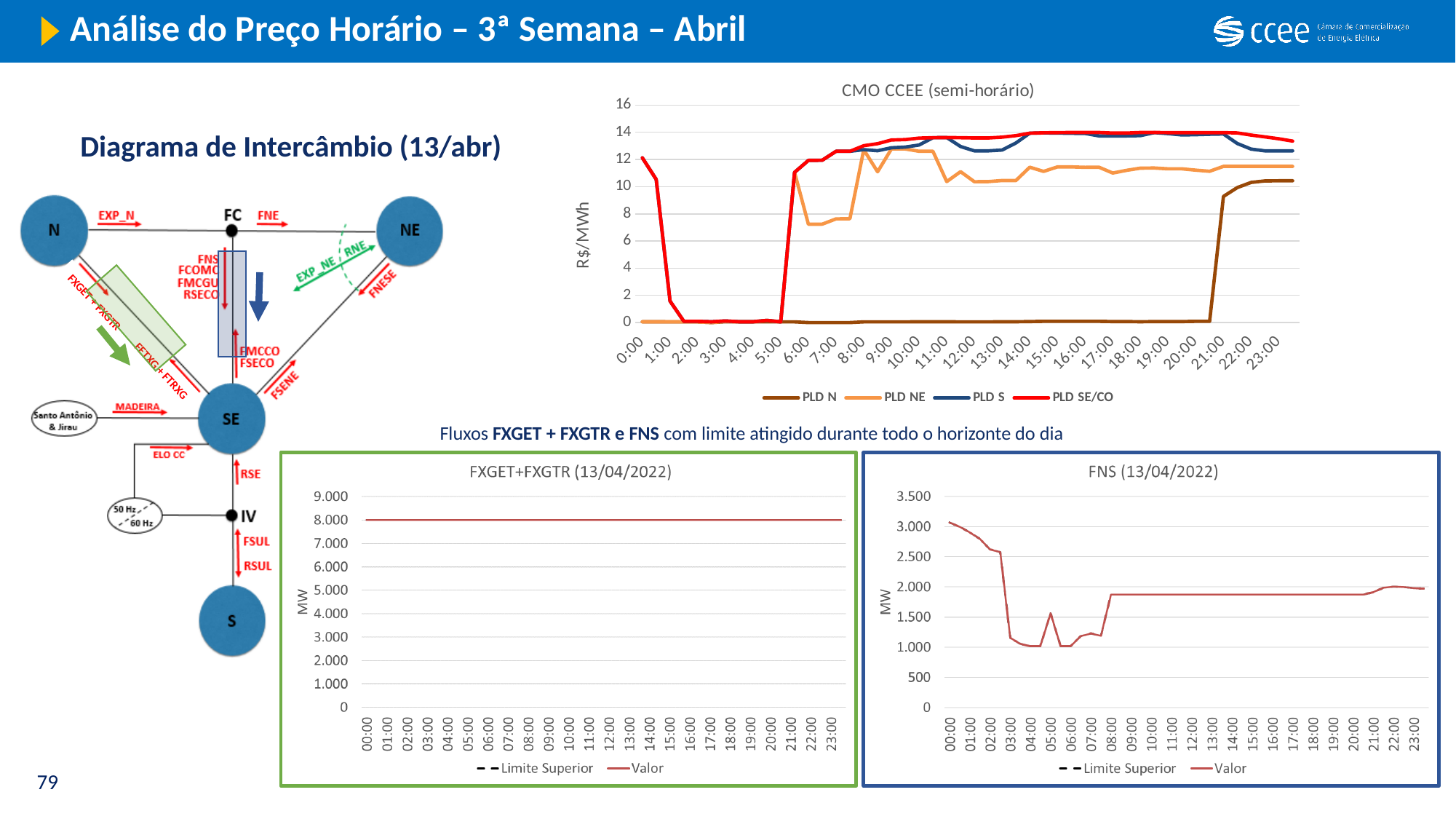
In the 'CMO CCEE (semi-horário)' chart, is the value of PLD N at 23:00 greater or less than 8? greater In the 'CMO CCEE (semi-horário)' chart, is the value of PLD N at 12:00 greater or less than 2? less In the 'FXGET+FXGTR (13/04/2022)' chart, does the Valor series rise, fall or stay constant across the day? stays constant In the 'CMO CCEE (semi-horário)' chart, is the value of PLD NE at 7:00 greater or less than 10? less What kind of chart is the 'CMO CCEE (semi-horário)' chart? line chart In the 'FNS (13/04/2022)' chart, at which hour is the Valor series highest? 00:00 In the 'FXGET+FXGTR (13/04/2022)' chart, what is the value of the Valor series at 12:00? 8.000 How many series does the legend of the 'CMO CCEE (semi-horário)' chart list? 4 How many series does the legend of the 'FNS (13/04/2022)' chart list? 2 In the 'CMO CCEE (semi-horário)' chart, what unit is shown on the vertical axis? R$/MWh